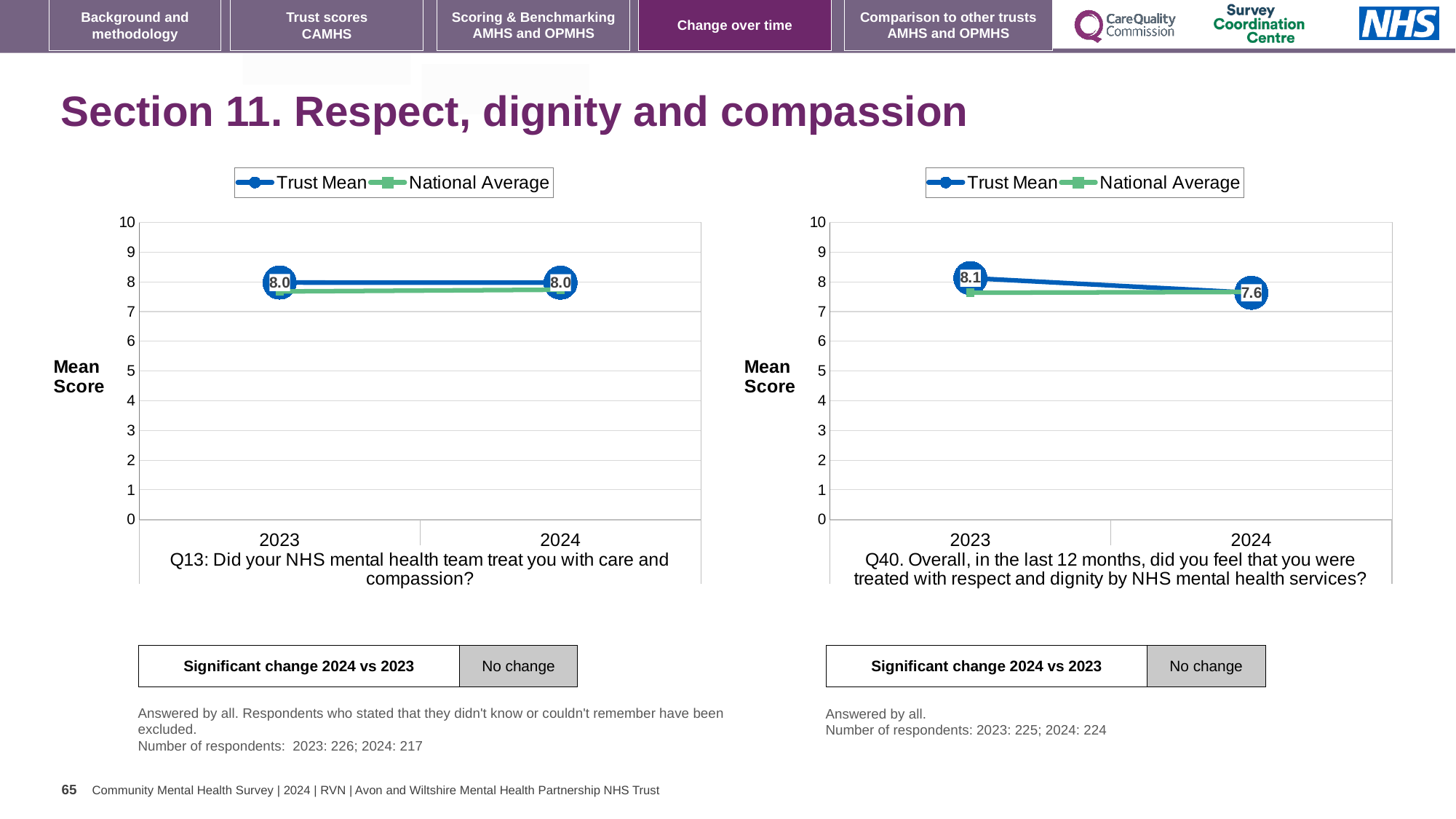
In the Q40 chart, is the National Average value for 2024 greater or less than 8? less In the Q40 chart, which year has the higher Trust Mean score, 2023 or 2024? 2023 How many series does the legend of the Q40 chart list? 2 In the Q40 chart, what is the Trust Mean score for 2023? 8.1 In the Q13 chart, what is the Trust Mean score for 2024? 8.0 In the Q13 chart, is the National Average value for 2023 greater or less than 7? greater How many years are shown on the x axis of the Q13 chart? 2 In the Q40 chart, what is the Trust Mean score for 2024? 7.6 In the Q40 chart, what is the difference between the Trust Mean scores for 2023 and 2024? 0.5 In the Q13 chart, what is the Trust Mean score for 2023? 8.0 What kind of chart is the Q13 chart? line chart In the Q40 chart, does the Trust Mean rise or fall from 2023 to 2024? fall